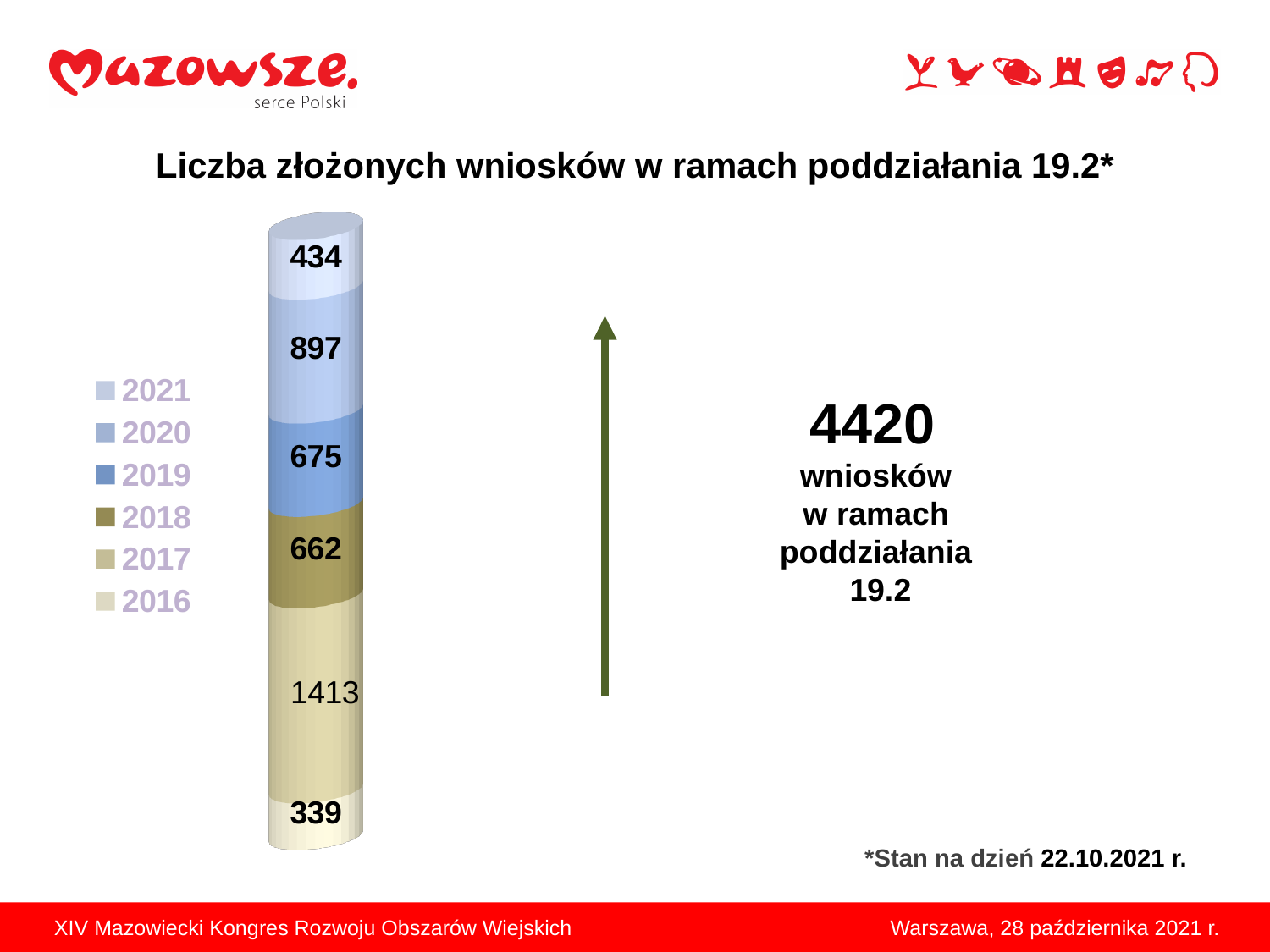
What is the value for 2019 in the stacked bar? 675 Which year has the highest number of submitted applications? 2017 What is the difference between the values for 2020 and 2018? 235 What is the title of the chart? Liczba złożonych wniosków w ramach poddziałania 19.2* What is the value for 2021 in the stacked bar? 434 What is the value for 2017 in the stacked bar? 1413 How many series does the legend list? 6 What kind of chart is shown on the slide? Stacked bar chart Which year has the lowest number of submitted applications? 2016 Which is larger, the value for 2019 or the value for 2018? 2019 What is the value for 2016 in the stacked bar? 339 What is the total of the stacked bar? 4420